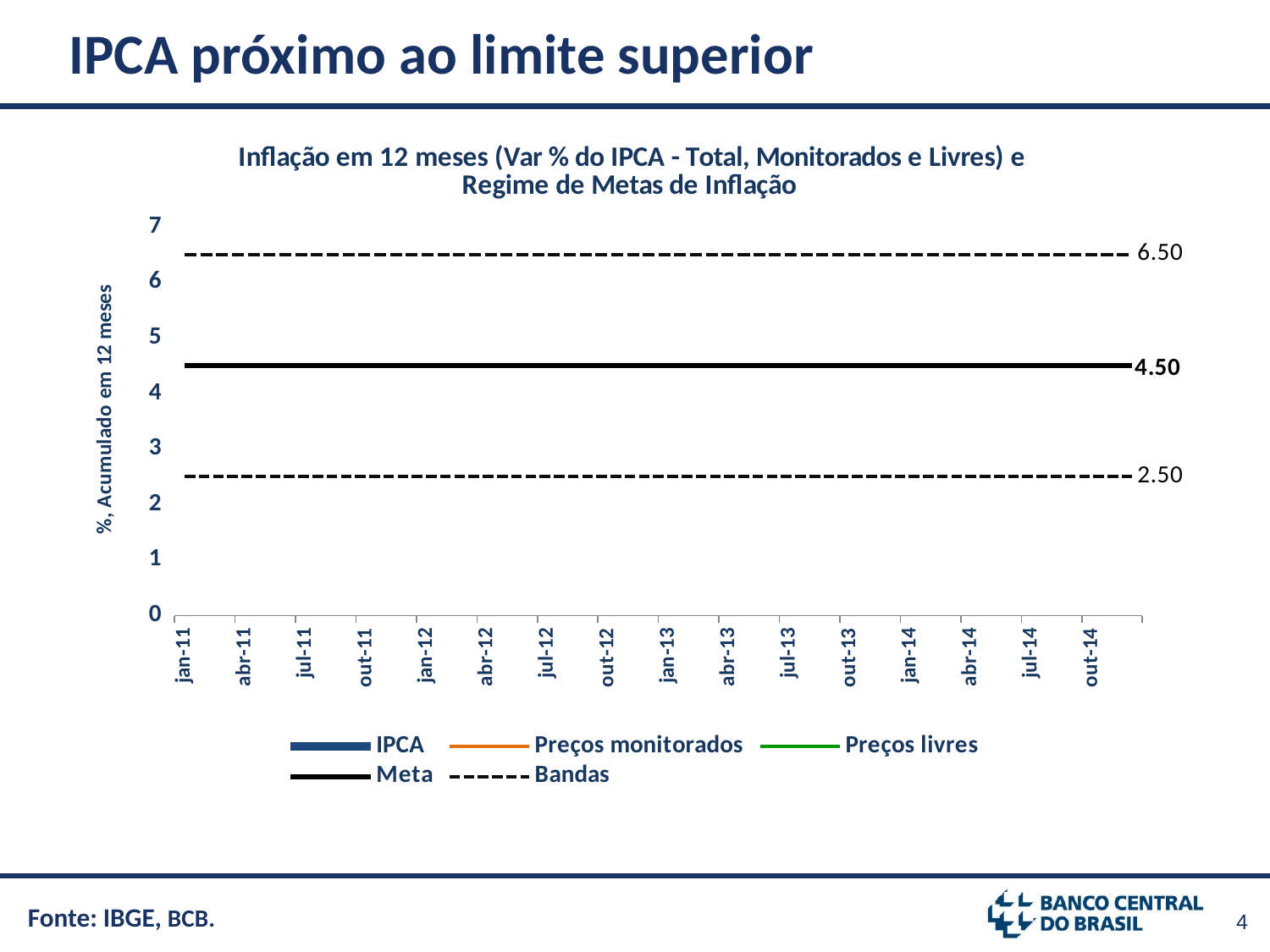
How many series does the legend list? 5 Is the value of the Meta line greater or less than 4? greater What kind of chart is shown on the slide? line chart What is the difference between the upper band (6.50) and the Meta line (4.50)? 2.00 How many date labels are shown on the x axis? 16 What value is labelled on the upper dashed Bandas line? 6.50 What is the difference between the upper band (6.50) and the lower band (2.50)? 4.00 What is the label of the y axis? %, Acumulado em 12 meses Does the Meta line rise, fall or stay flat from jan-11 to out-14? stays flat What value is labelled on the solid black Meta line? 4.50 What value is labelled on the lower dashed Bandas line? 2.50 Which is higher, the Meta line or the lower Bandas line? Meta